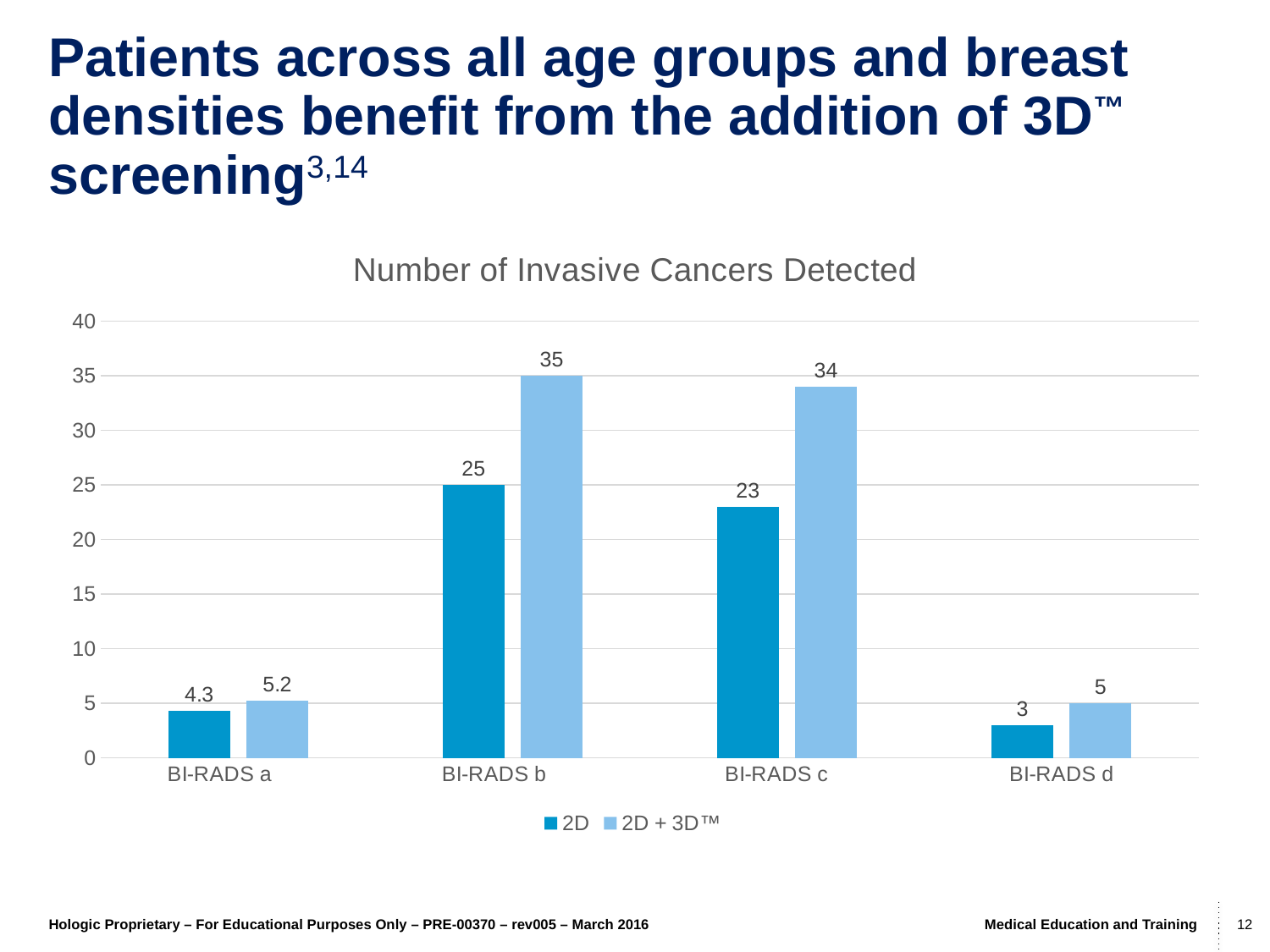
How many series does the legend list? 2 What is the 2D + 3D™ value for BI-RADS c? 34 What is the 2D value for BI-RADS b? 25 What is the 2D + 3D™ value for BI-RADS a? 5.2 What kind of chart is shown? Bar chart Which category has the highest 2D + 3D™ value? BI-RADS b Which is larger: the 2D value for BI-RADS b or the 2D value for BI-RADS c? 2D value for BI-RADS b How many categories are shown on the x axis? 4 Which category has the lowest 2D value? BI-RADS d What is the title of the chart? Number of Invasive Cancers Detected What is the 2D value for BI-RADS d? 3 What is the difference between the 2D + 3D™ and 2D values for BI-RADS c? 11